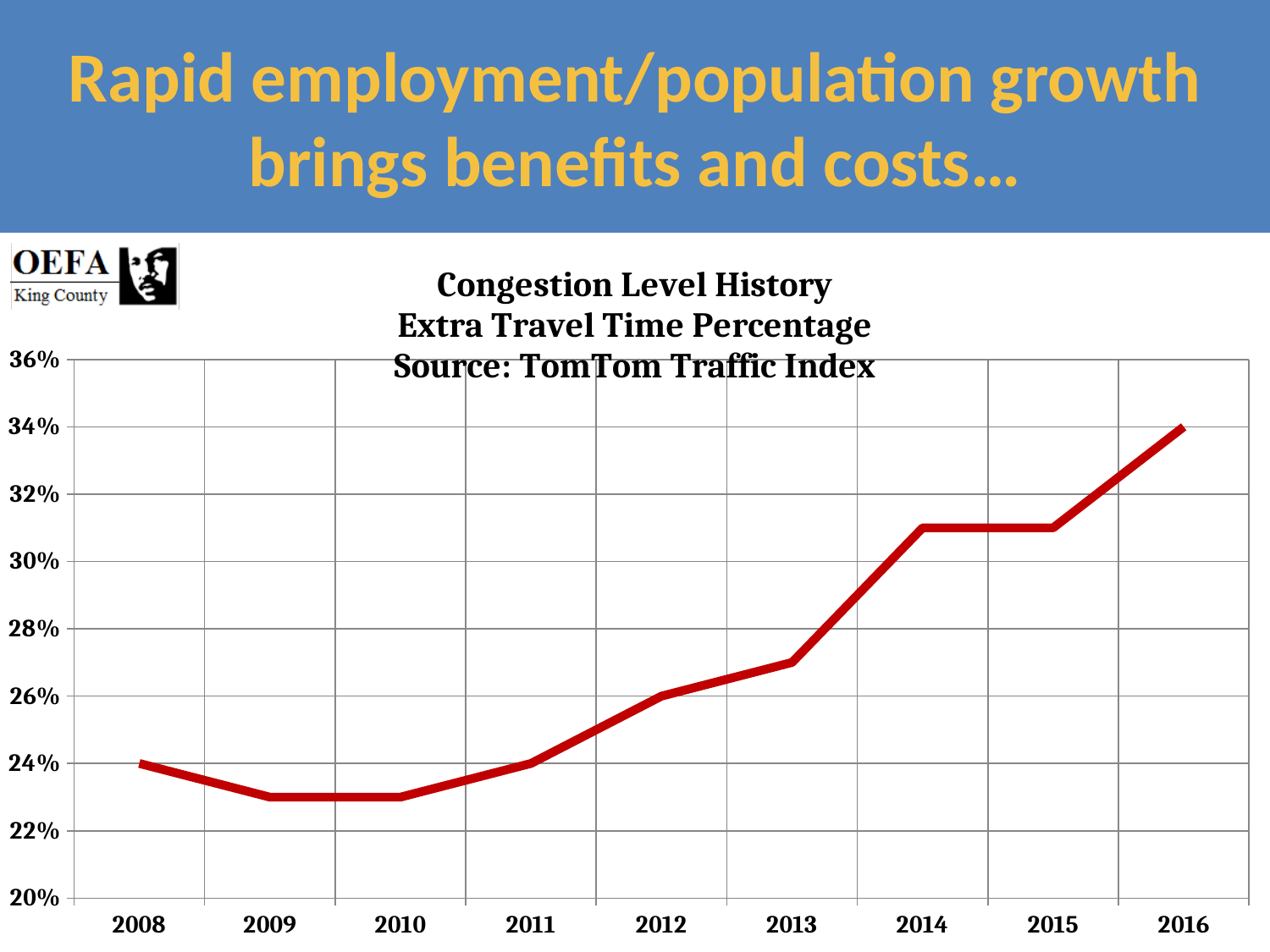
Which year has the highest extra travel time percentage? 2016 What is the extra travel time percentage for 2016? 34% Is the value for 2013 greater or less than 28%? less What kind of chart is shown on the slide? line chart What is the extra travel time percentage for 2012? 26% Does the extra travel time percentage rise or fall from 2011 to 2016? rise What is the extra travel time percentage for 2008? 24% Is the value for 2009 greater or less than 24%? less How many years are plotted on the x axis? 9 What source is cited in the chart title? TomTom Traffic Index Which is larger, the value for 2015 or the value for 2013? 2015 Is the value for 2014 greater or less than 30%? greater